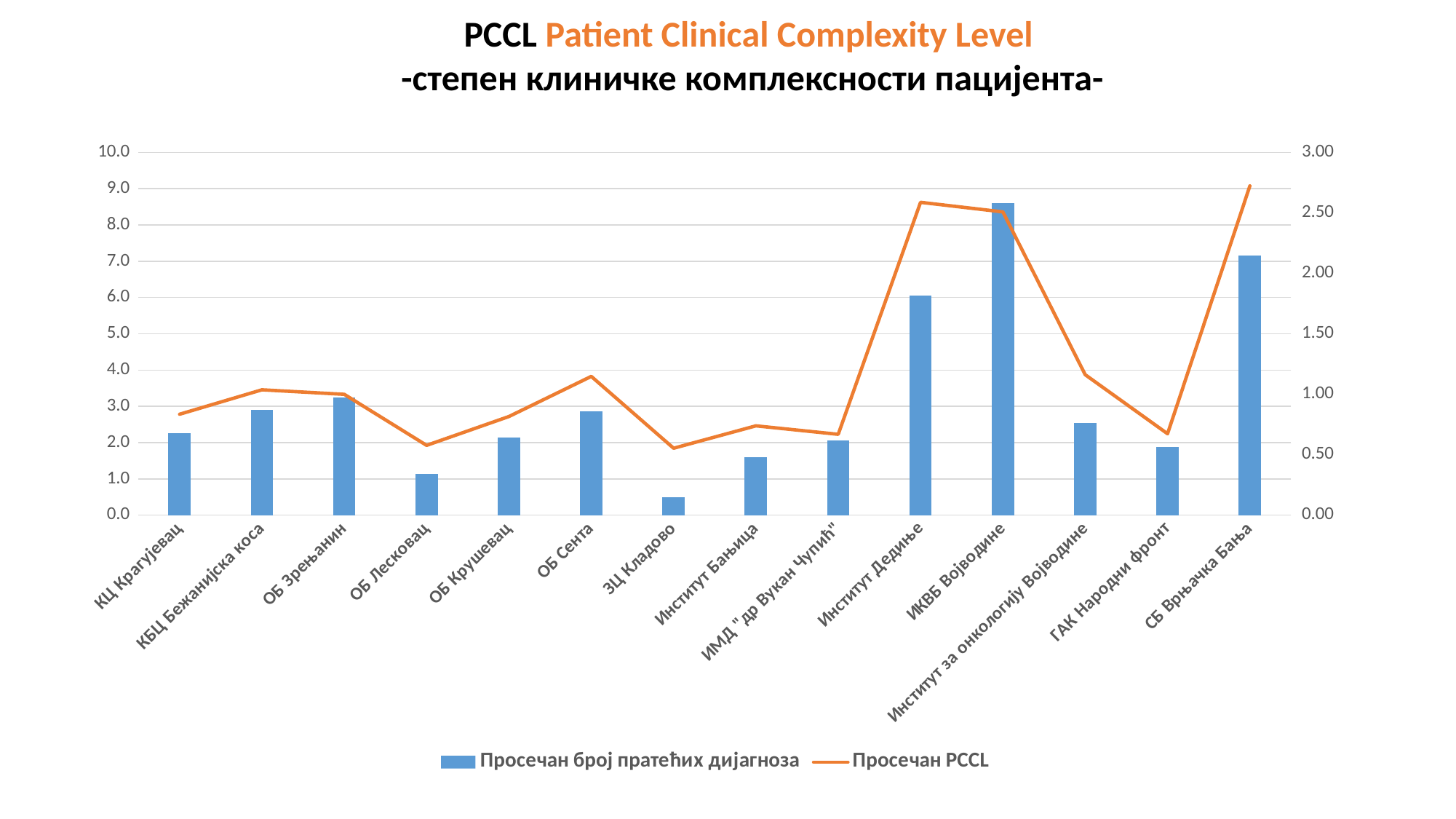
Is the Просечан PCCL value for ГАК Народни фронт greater or less than 1.00? less Which has the larger Просечан број пратећих дијагноза bar, Институт Дедиње or ИКВБ Војводине? ИКВБ Војводине Which institution has the highest bar for Просечан број пратећих дијагноза? ИКВБ Војводине What kind of chart is shown on the slide? A combination bar and line chart How many institutions (categories) are shown on the x axis? 14 How many series does the legend list? 2 Is the Просечан PCCL value for СБ Врњачка Бања greater or less than 2.50? greater Which series is drawn as an orange line? Просечан PCCL Which institution has the lowest bar for Просечан број пратећих дијагноза? ЗЦ Кладово Is the Просечан број пратећих дијагноза bar for ЗЦ Кладово greater or less than 1.0? less Which institution has the highest value on the Просечан PCCL line? СБ Врњачка Бања